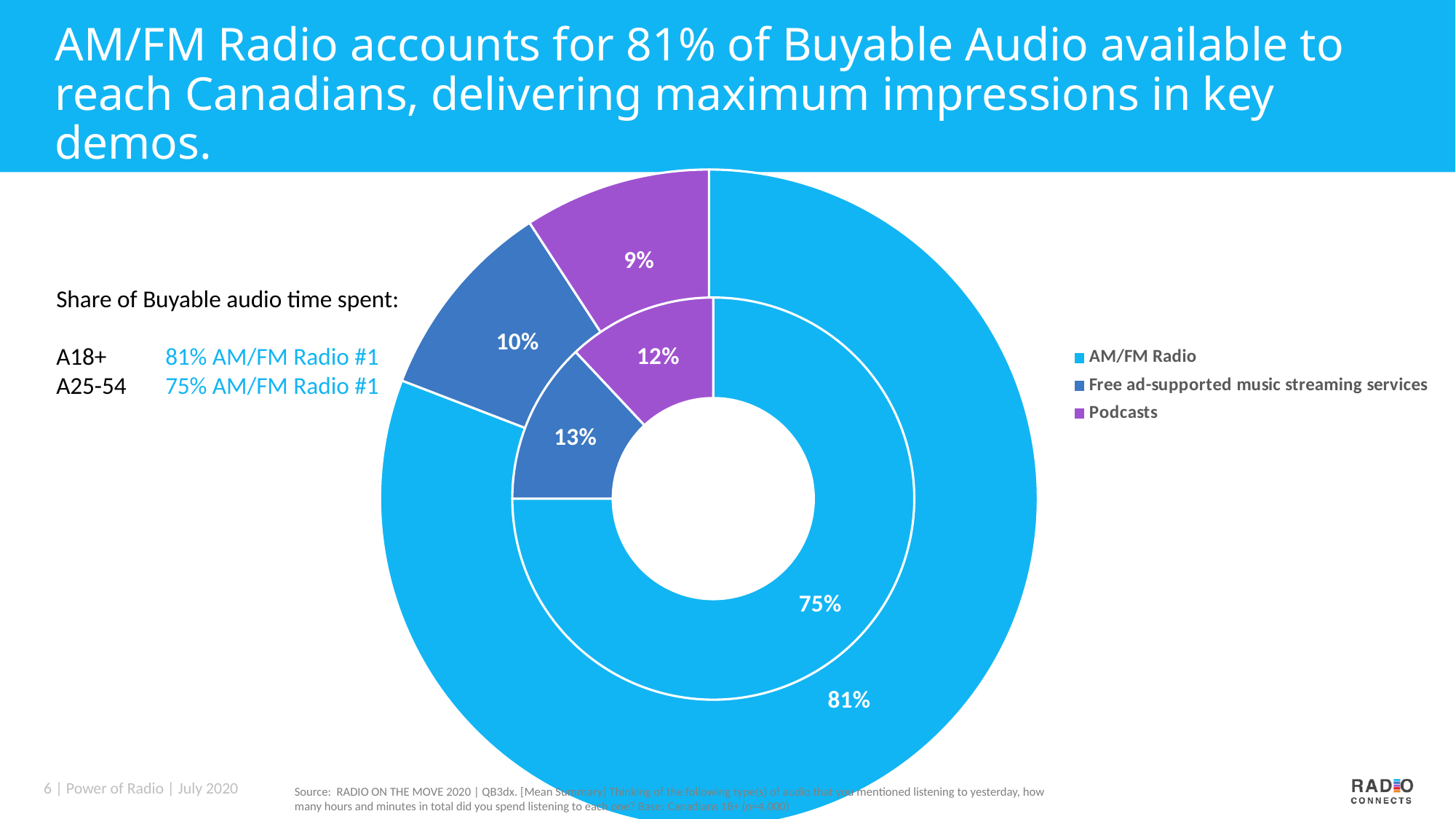
What kind of chart is shown on the slide? Doughnut chart In the outer ring, which is larger: Free ad-supported music streaming services or Podcasts? Free ad-supported music streaming services In the inner ring, what share does AM/FM Radio have? 75% What is the difference between the AM/FM Radio share in the outer ring and in the inner ring? 6 percentage points In the inner ring, what share do Free ad-supported music streaming services have? 13% In the outer ring, what share does AM/FM Radio have? 81% Which category has the smallest share in the outer ring? Podcasts Which category has the largest share in the outer ring? AM/FM Radio In the outer ring, what share do Podcasts have? 9% How many series does the legend list? 3 Which legend entry is shown in purple? Podcasts In the inner ring, what share do Podcasts have? 12%